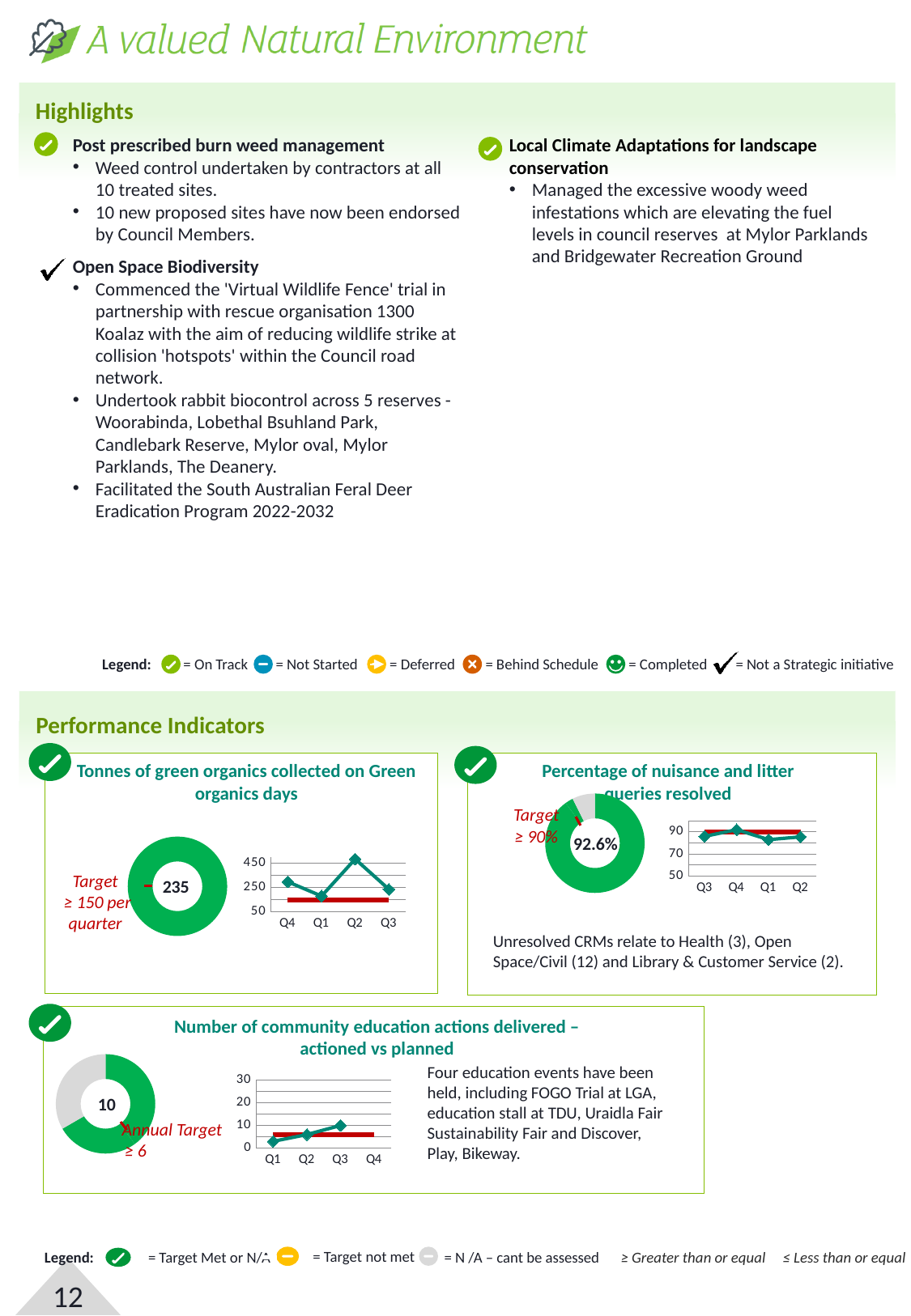
On the 'Number of community education actions delivered – actioned vs planned' chart, what value is shown in the centre of the donut? 10 On the 'Percentage of nuisance and litter queries resolved' chart, what percentage is shown in the centre of the donut? 92.6% On the 'Percentage of nuisance and litter queries resolved' chart, what is the stated target? ≥ 90% On the 'Tonnes of green organics collected on Green organics days' line chart, which quarter has the lowest value? Q1 What type of chart is used to show the quarterly values on the 'Number of community education actions delivered – actioned vs planned' panel? line chart On the 'Percentage of nuisance and litter queries resolved' line chart, is the value for Q1 greater or less than 90? less On the 'Tonnes of green organics collected on Green organics days' line chart, which quarter has the highest value? Q2 On the 'Tonnes of green organics collected on Green organics days' chart, what value is shown in the centre of the donut? 235 On the 'Number of community education actions delivered – actioned vs planned' line chart, do the values rise or fall from Q1 to Q3? rise On the 'Tonnes of green organics collected on Green organics days' chart, what is the stated target? ≥ 150 per quarter On the 'Tonnes of green organics collected on Green organics days' line chart, is the value for Q2 greater or less than 250? greater On the 'Tonnes of green organics collected on Green organics days' line chart, how many quarters are plotted on the x axis? 4